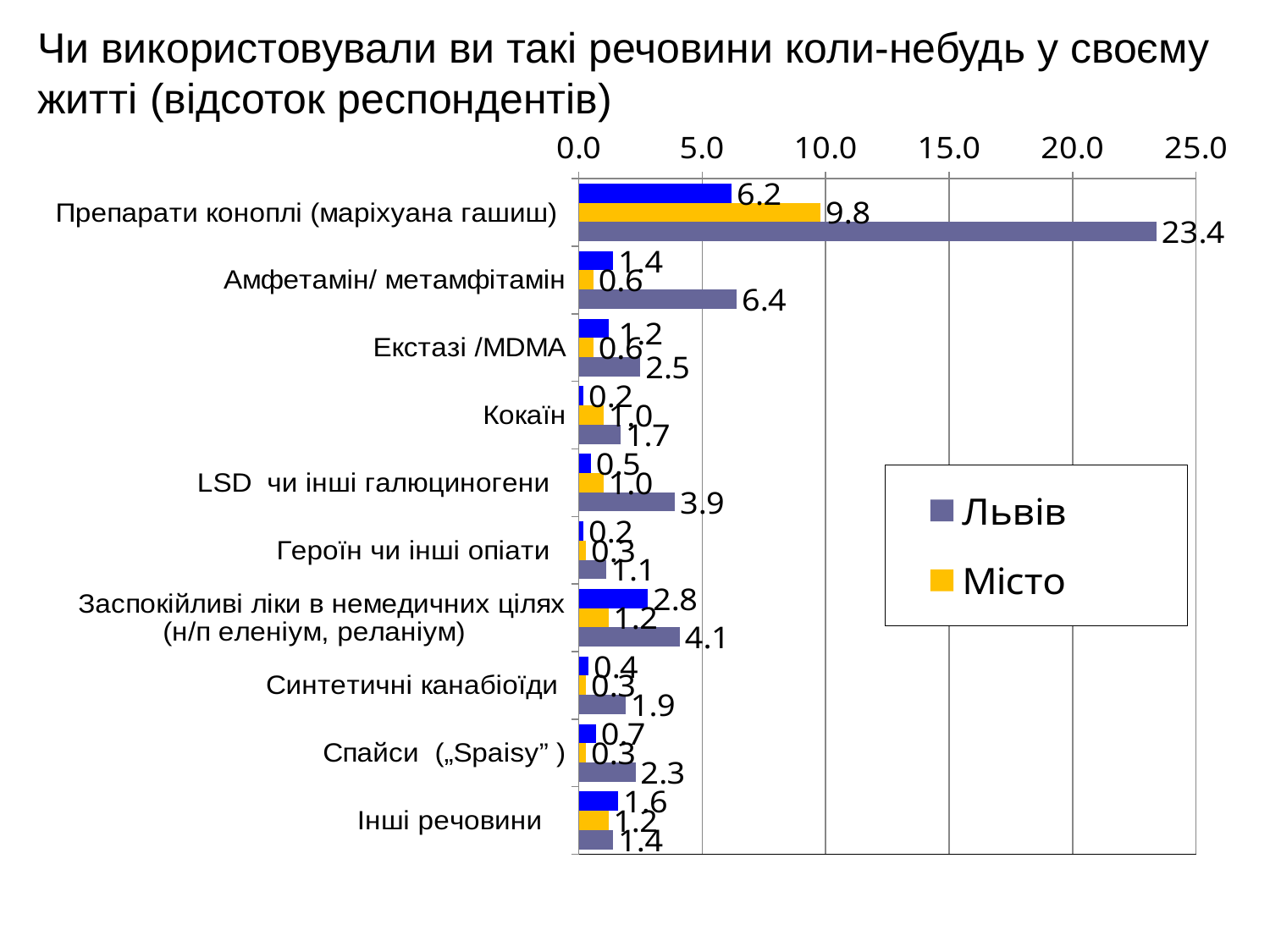
What is the value for Львів for Препарати коноплі (маріхуана гашиш)? 23.4 What is the value for Місто for Препарати коноплі (маріхуана гашиш)? 9.8 How many categories are shown on the chart? 10 What kind of chart is shown on the slide? Bar chart Which category has the lowest value for Львів? Героїн чи інші опіати Which category has the highest value for Львів? Препарати коноплі (маріхуана гашиш) What is the difference between the Львів and Місто values for Препарати коноплі (маріхуана гашиш)? 13.6 Is the Львів value for Препарати коноплі (маріхуана гашиш) greater or less than 20.0? greater What is the value for Львів for Амфетамін/ метамфітамін? 6.4 Which is larger for Заспокійливі ліки в немедичних цілях: the Львів value or the Місто value? Львів How many series does the legend list? 2 What is the value for Місто for LSD чи інші галюциногени? 1.0